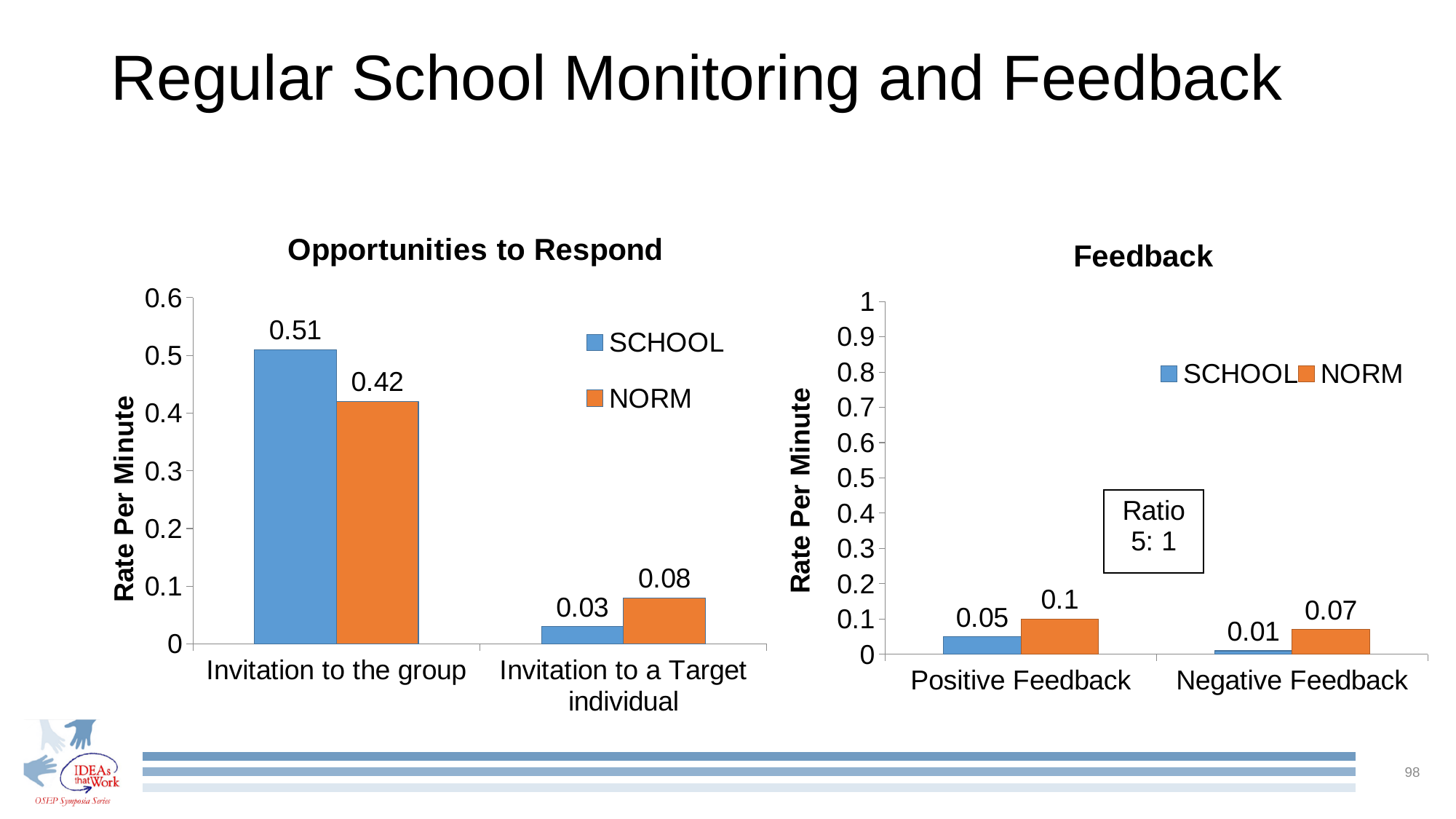
In the Feedback chart, what is the SCHOOL value for Negative Feedback? 0.01 In the Feedback chart, which series has the higher value for Negative Feedback, SCHOOL or NORM? NORM What kind of chart is the Opportunities to Respond chart? Bar chart In the Opportunities to Respond chart, what is the SCHOOL value for Invitation to the group? 0.51 In the Opportunities to Respond chart, which bar has the highest value? SCHOOL, Invitation to the group In the Opportunities to Respond chart, what is the NORM value for Invitation to a Target individual? 0.08 In the Opportunities to Respond chart, which series has the higher value for Invitation to a Target individual, SCHOOL or NORM? NORM How many series does the legend of the Feedback chart list? 2 In the Feedback chart, which bar has the lowest value? SCHOOL, Negative Feedback In the Feedback chart, what is the difference between the NORM and SCHOOL values for Positive Feedback? 0.05 In the Feedback chart, what is the NORM value for Positive Feedback? 0.1 In the Opportunities to Respond chart, what is the difference between the SCHOOL and NORM values for Invitation to the group? 0.09